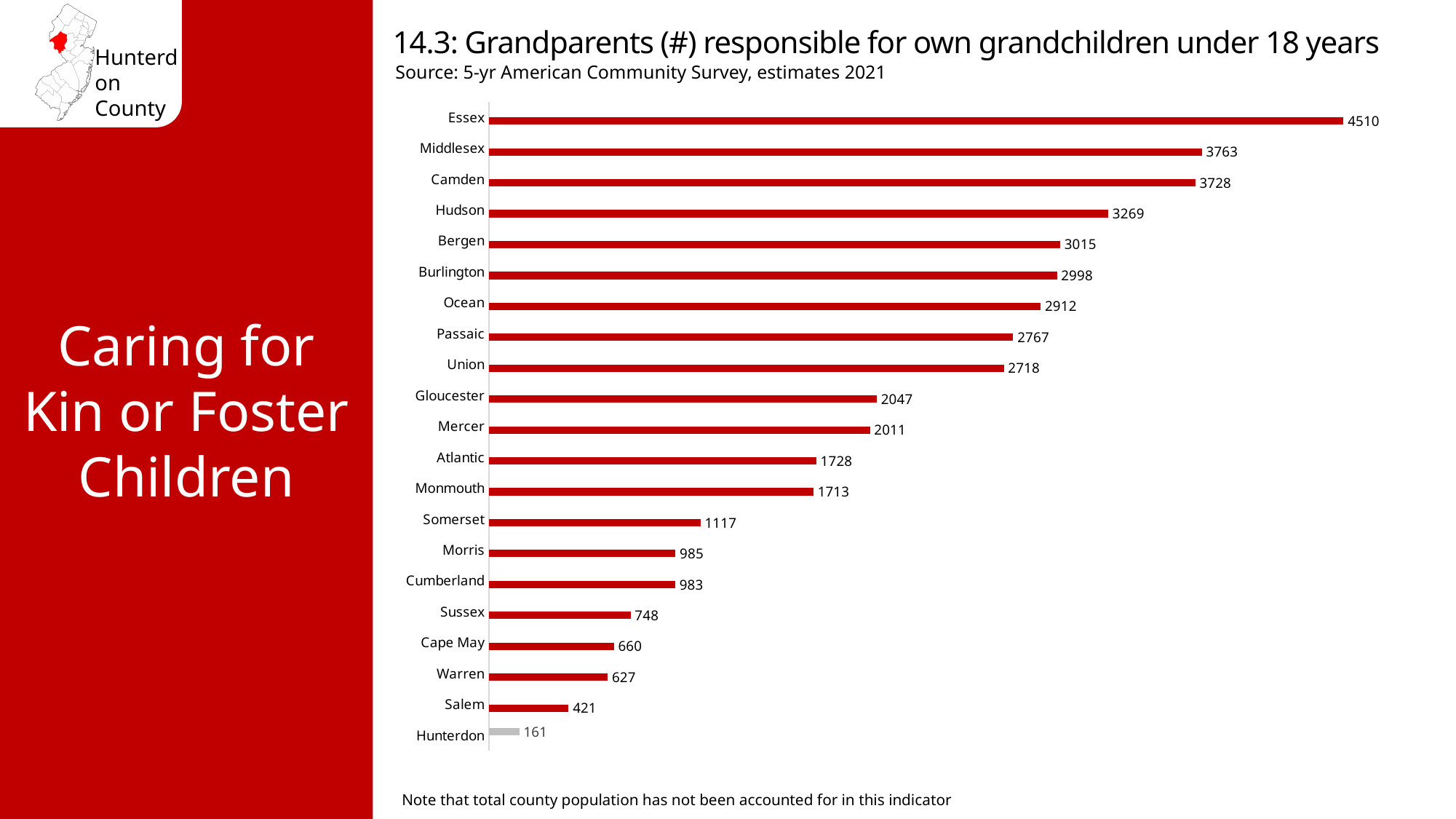
Which county has the highest value? Essex Which is larger, the value for Sussex or the value for Somerset? Somerset What is the difference between the values for Salem and Hunterdon? 260 How many counties are shown in the chart? 21 What kind of chart is shown on the slide? Bar chart Which county's bar is shown in grey rather than red? Hunterdon Which is larger, the value for Hudson or the value for Bergen? Hudson What is the value for Essex? 4510 What is the difference between the values for Essex and Middlesex? 747 What is the value for Gloucester? 2047 What is the value for Hunterdon? 161 Which county has the lowest value? Hunterdon